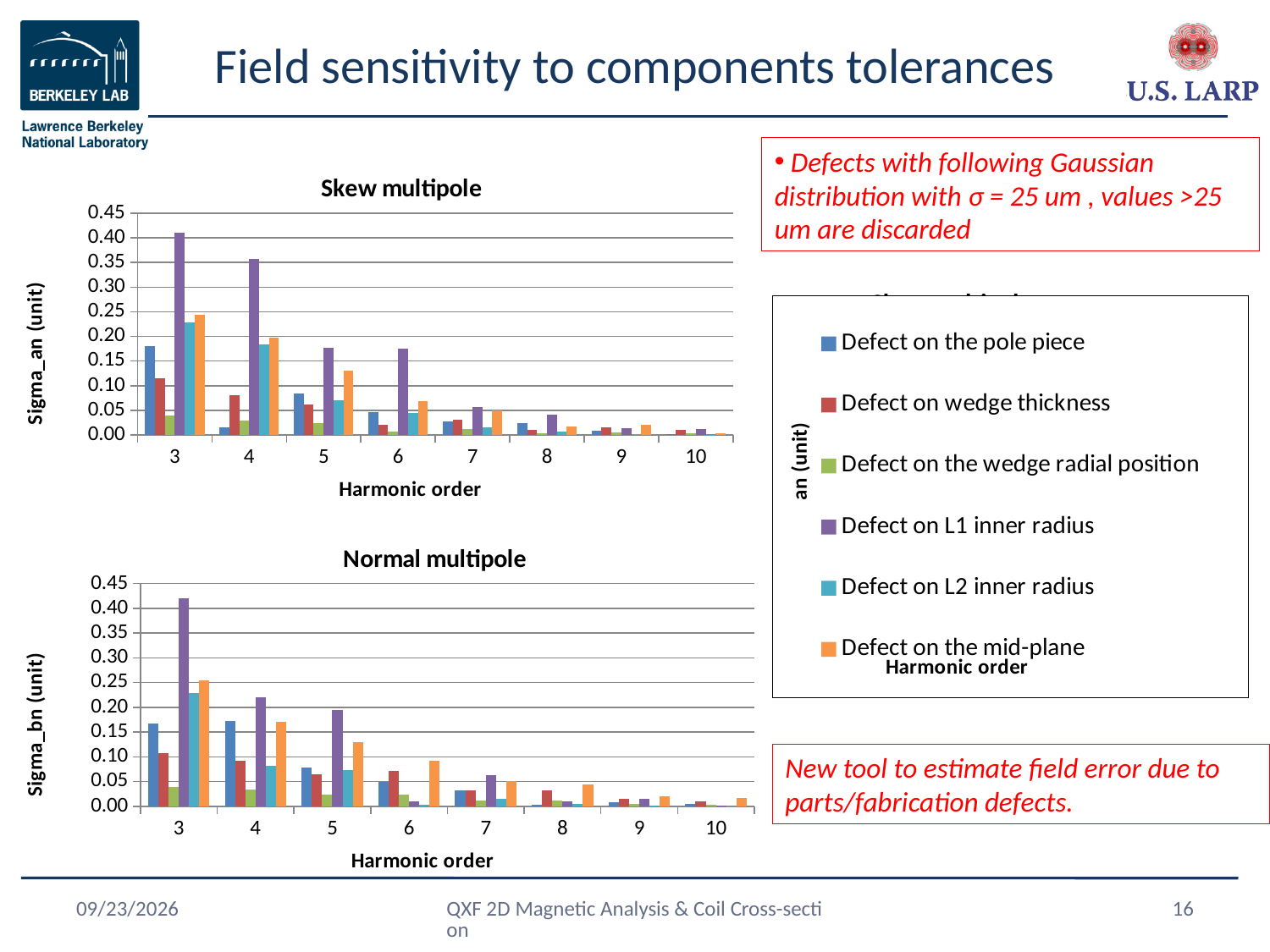
In the Normal multipole chart, do the values generally rise or fall as the harmonic order increases? fall In the Skew multipole chart, which series has the tallest bar at harmonic order 3? Defect on L1 inner radius In the Skew multipole chart, at harmonic order 4, which is larger: Defect on L1 inner radius or Defect on the mid-plane? Defect on L1 inner radius In the Normal multipole chart, at which harmonic order does the tallest bar occur? 3 What is the y-axis label of the Skew multipole chart? Sigma_an (unit) In the Skew multipole chart, is the value for Defect on the pole piece at harmonic order 3 greater or less than 0.20? less In the Normal multipole chart, is the value for Defect on the mid-plane at harmonic order 3 greater or less than 0.20? greater In the Normal multipole chart, at harmonic order 5, which is larger: Defect on L1 inner radius or Defect on the mid-plane? Defect on L1 inner radius How many series does the legend list for the multipole charts? 6 How many harmonic orders are shown on the x axis of the Normal multipole chart? 8 In the Skew multipole chart, is the value for Defect on L1 inner radius at harmonic order 3 greater or less than 0.35? greater What type of chart is the Skew multipole chart? bar chart